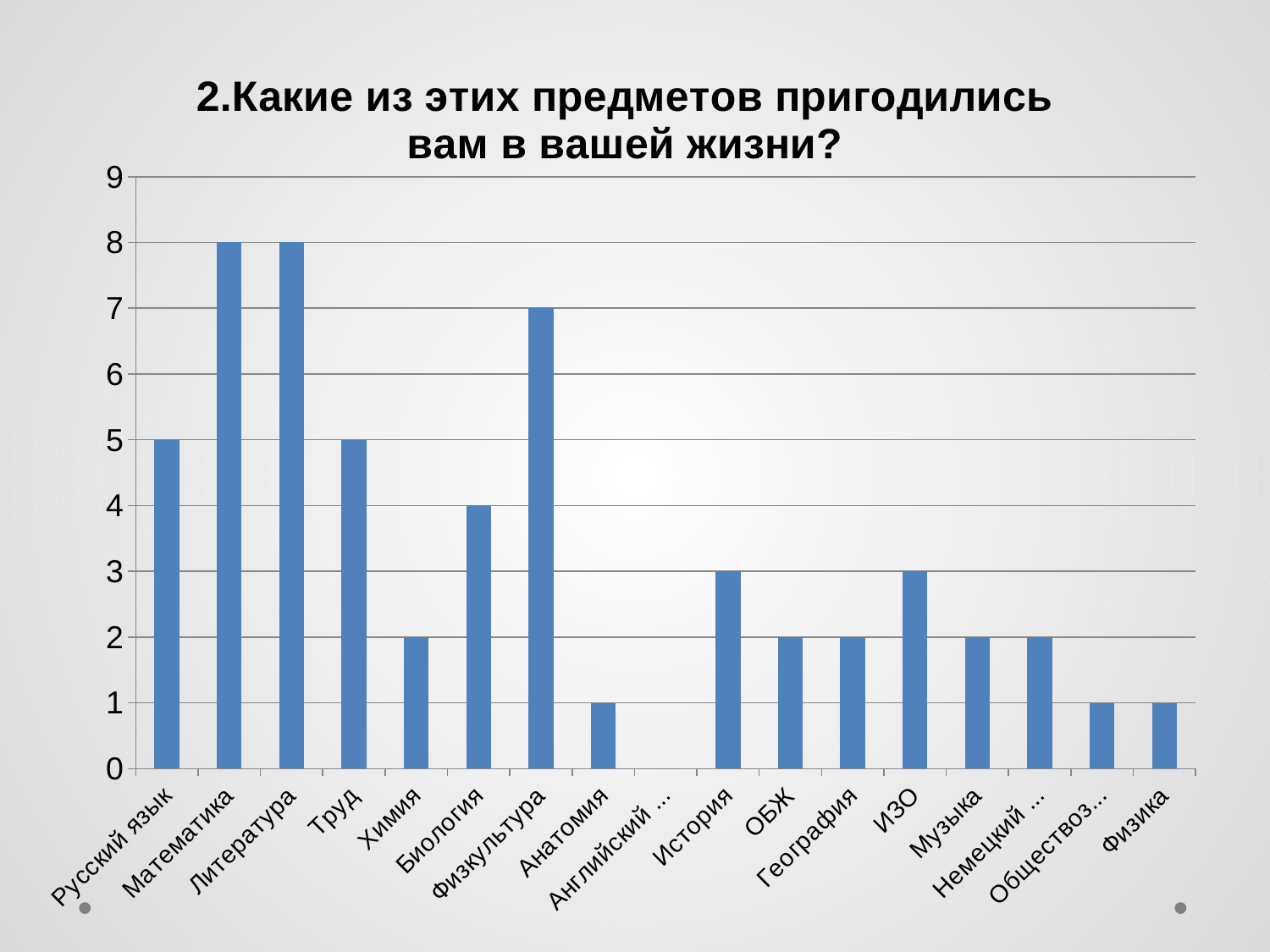
What is the value for История? 3 Is the value for Физкультура greater or less than 5? greater What is the value for Анатомия? 1 What is the title of the chart? 2.Какие из этих предметов пригодились вам в вашей жизни? What is the value for Математика? 8 How many categories are shown on the x axis? 17 What type of chart is shown on the slide? Bar chart What is the value for Физкультура? 7 Which is larger, the value for Труд or the value for Химия? Труд What is the difference between the values for Литература and Физкультура? 1 What is the value for Русский язык? 5 What is the value for Биология? 4